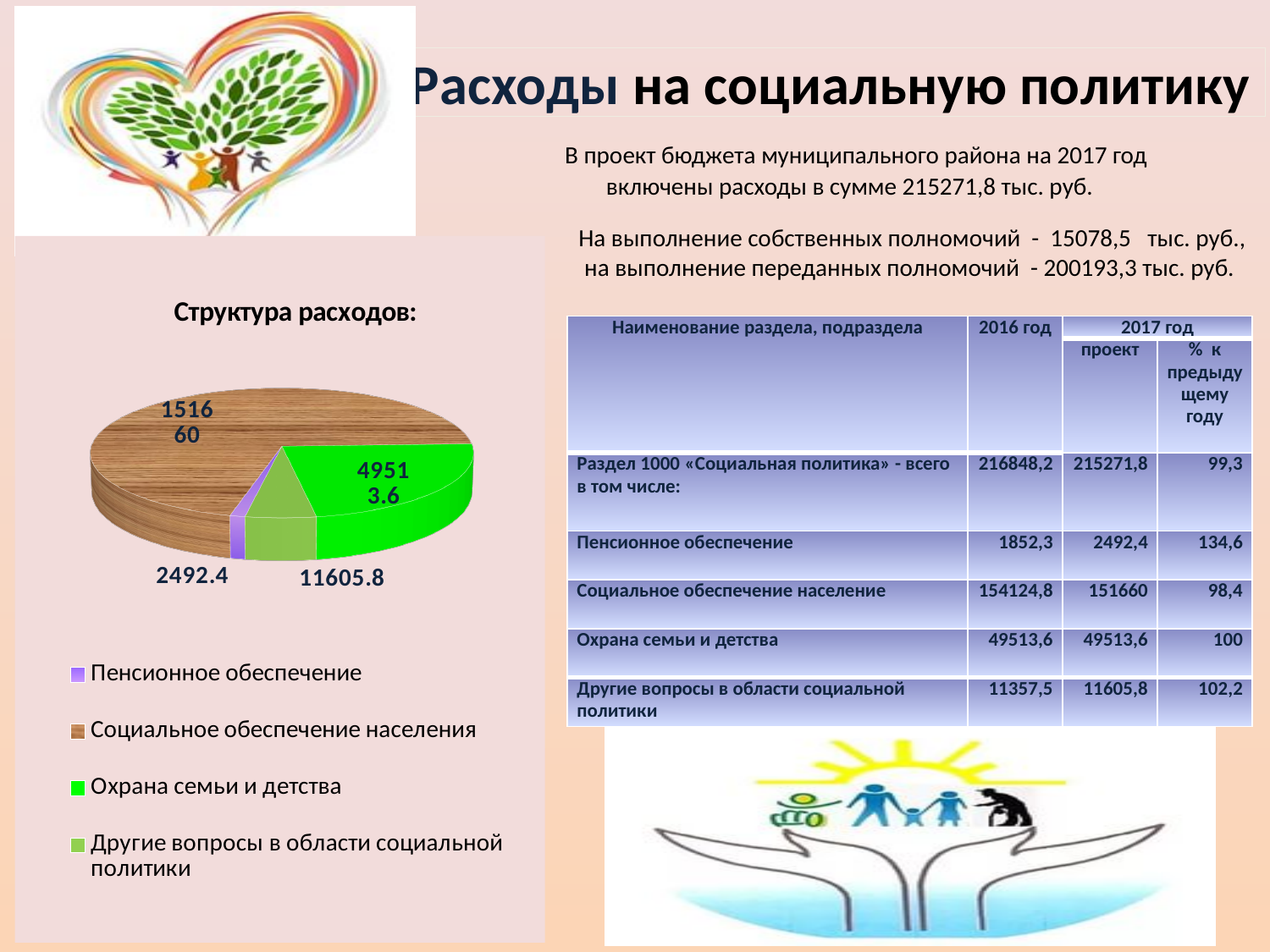
How many slices does the "Структура расходов:" pie chart have? 4 Which category has the smallest slice in the "Структура расходов:" pie chart? Пенсионное обеспечение In the "Структура расходов:" pie chart, what is the difference between the values for "Другие вопросы в области социальной политики" and "Пенсионное обеспечение"? 9113.4 In the "Структура расходов:" pie chart, what colour is the slice for "Охрана семьи и детства"? green What kind of chart is shown under the title "Структура расходов:"? pie chart In the "Структура расходов:" pie chart, what value is labelled for "Другие вопросы в области социальной политики"? 11605.8 In the "Структура расходов:" pie chart, which slice is larger: "Пенсионное обеспечение" or "Другие вопросы в области социальной политики"? Другие вопросы в области социальной политики Which category has the largest slice in the "Структура расходов:" pie chart? Социальное обеспечение населения In the "Структура расходов:" pie chart, what value is labelled for "Пенсионное обеспечение"? 2492.4 How many entries does the legend of the "Структура расходов:" pie chart list? 4 In the "Структура расходов:" pie chart, which slice is larger: "Охрана семьи и детства" or "Другие вопросы в области социальной политики"? Охрана семьи и детства What is the title of the pie chart on the slide? Структура расходов: